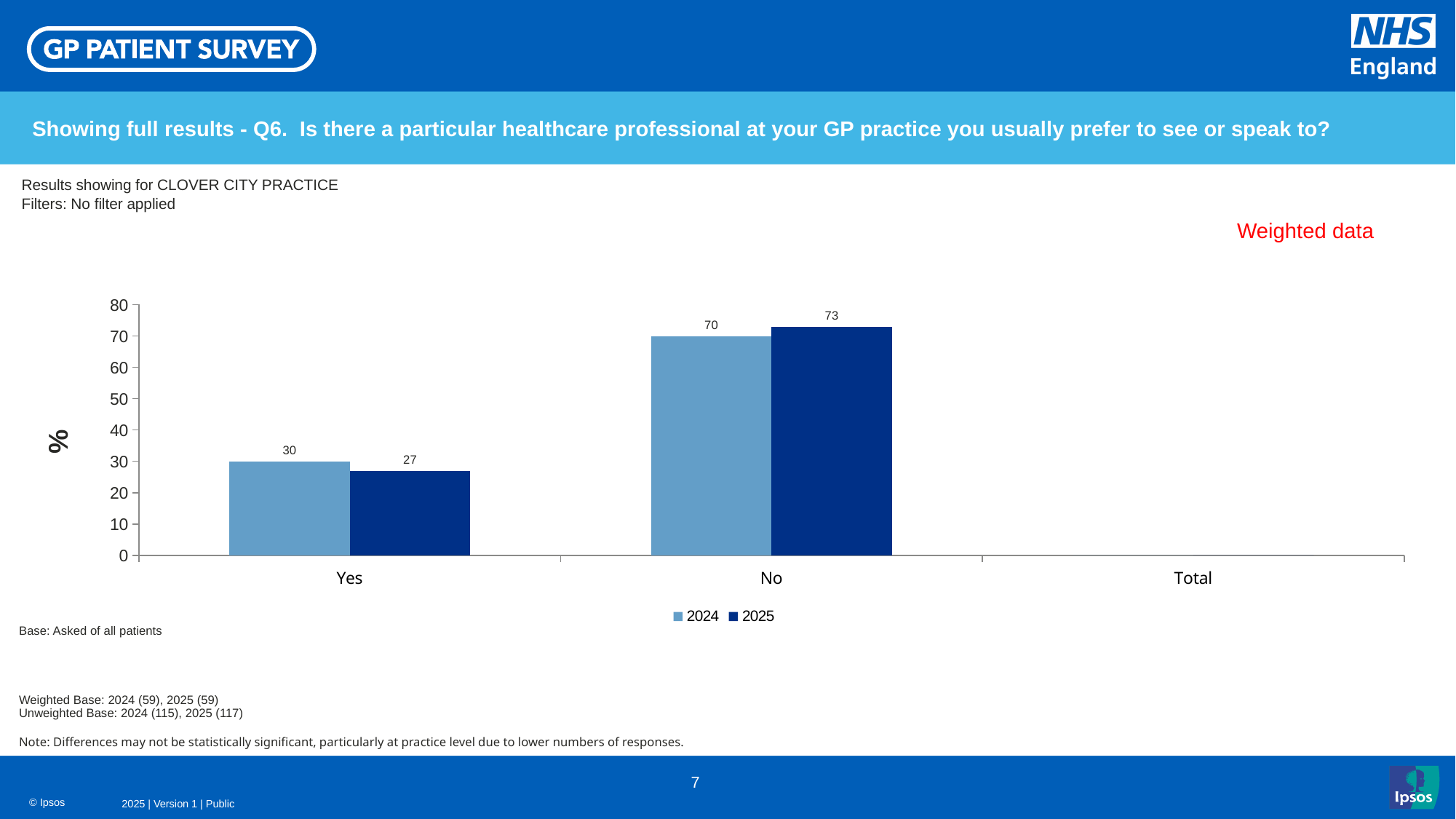
Which is larger for the 'Yes' category: the 2024 value or the 2025 value? 2024 What is the 2025 value for the 'Yes' category? 27 What is the 2024 value for the 'No' category? 70 What is the difference between the 2025 and 2024 values for the 'No' category? 3 Is the 2024 value for 'No' greater or less than 60? greater What is the label on the vertical axis of the chart? % What kind of chart is shown on the slide? Bar chart Which category has the highest value for the 2025 series? No What is the 2024 value for the 'Yes' category? 30 Which category has the lowest value for the 2024 series? Yes How many series does the legend list? 2 What is the 2025 value for the 'No' category? 73